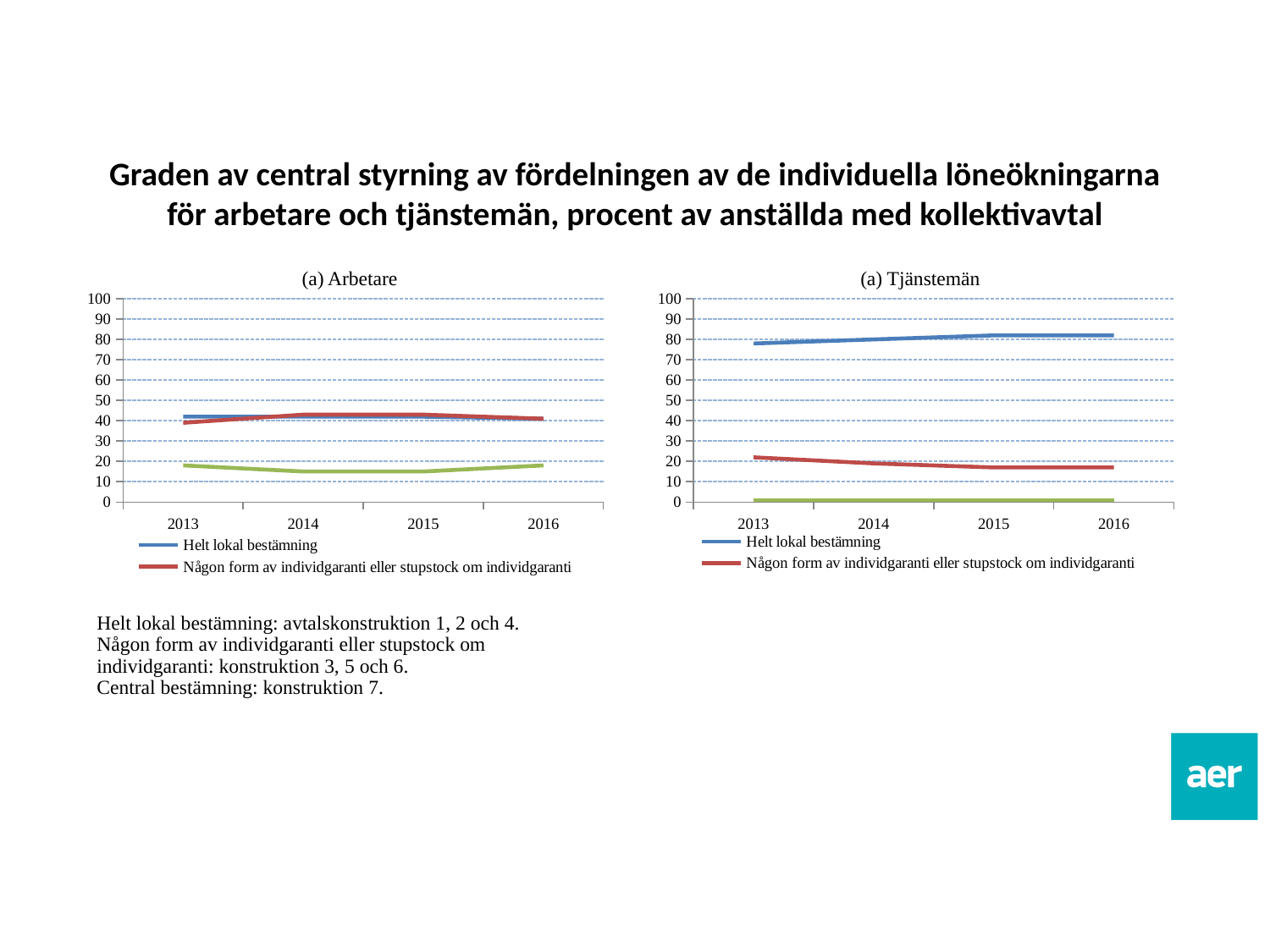
In the "(a) Tjänstemän" chart, does the line for Helt lokal bestämning rise or fall from 2013 to 2016? rise How many series does the legend of the "(a) Arbetare" chart list? 2 In the "(a) Tjänstemän" chart, which series is higher in 2016: Helt lokal bestämning or Någon form av individgaranti eller stupstock om individgaranti? Helt lokal bestämning In the "(a) Tjänstemän" chart, how many years are shown on the x axis? 4 In the "(a) Arbetare" chart, is the value for Någon form av individgaranti eller stupstock om individgaranti in 2014 greater or less than 30? greater What is the title of the chart on the right side of the slide? (a) Tjänstemän In the "(a) Arbetare" chart, is the value for Helt lokal bestämning in 2013 greater or less than 30? greater In the "(a) Tjänstemän" chart, is the value for Helt lokal bestämning in 2013 greater or less than 70? greater In the "(a) Tjänstemän" chart, does the line for Någon form av individgaranti eller stupstock om individgaranti rise or fall from 2013 to 2016? fall In the "(a) Tjänstemän" chart, which legend series has the highest values across all years? Helt lokal bestämning What kind of chart is the "(a) Arbetare" chart? line chart